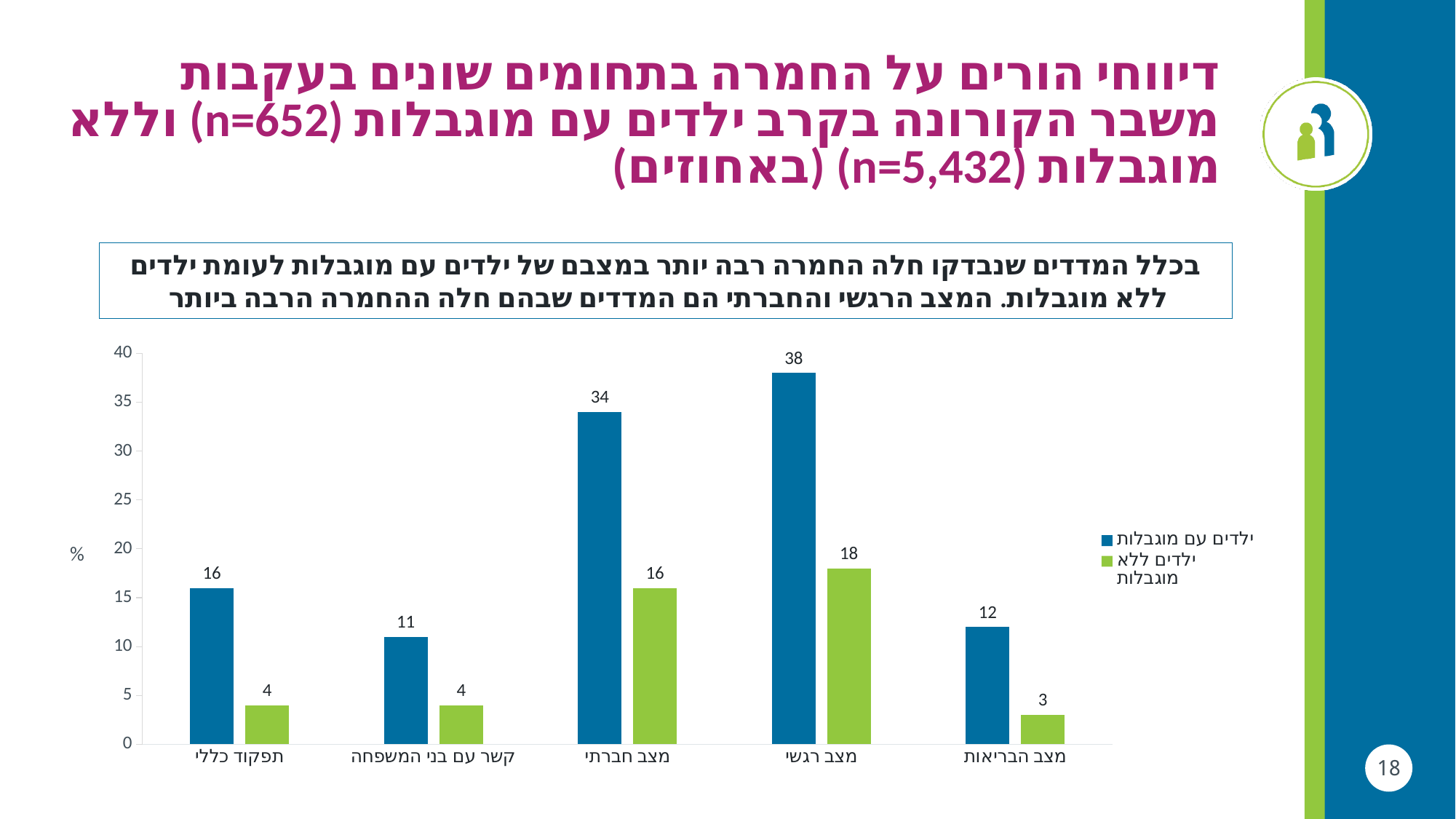
What kind of chart is shown on the slide? bar chart How many series does the chart legend list? 2 Is the value for ילדים עם מוגבלות in מצב חברתי greater or less than 30? greater What is the difference between the ילדים עם מוגבלות and ילדים ללא מוגבלות values in the מצב רגשי category? 20 What value is shown for ילדים עם מוגבלות in the מצב רגשי category? 38 Which colour represents the ילדים ללא מוגבלות series in the chart? green Which category has the highest value for ילדים עם מוגבלות? מצב רגשי How many categories are shown on the x axis of the chart? 5 What value is shown for ילדים עם מוגבלות in the קשר עם בני המשפחה category? 11 What value is shown for ילדים ללא מוגבלות in the מצב חברתי category? 16 Which is larger: the ילדים עם מוגבלות value for תפקוד כללי or for מצב הבריאות? תפקוד כללי Which category has the lowest value for ילדים ללא מוגבלות? מצב הבריאות